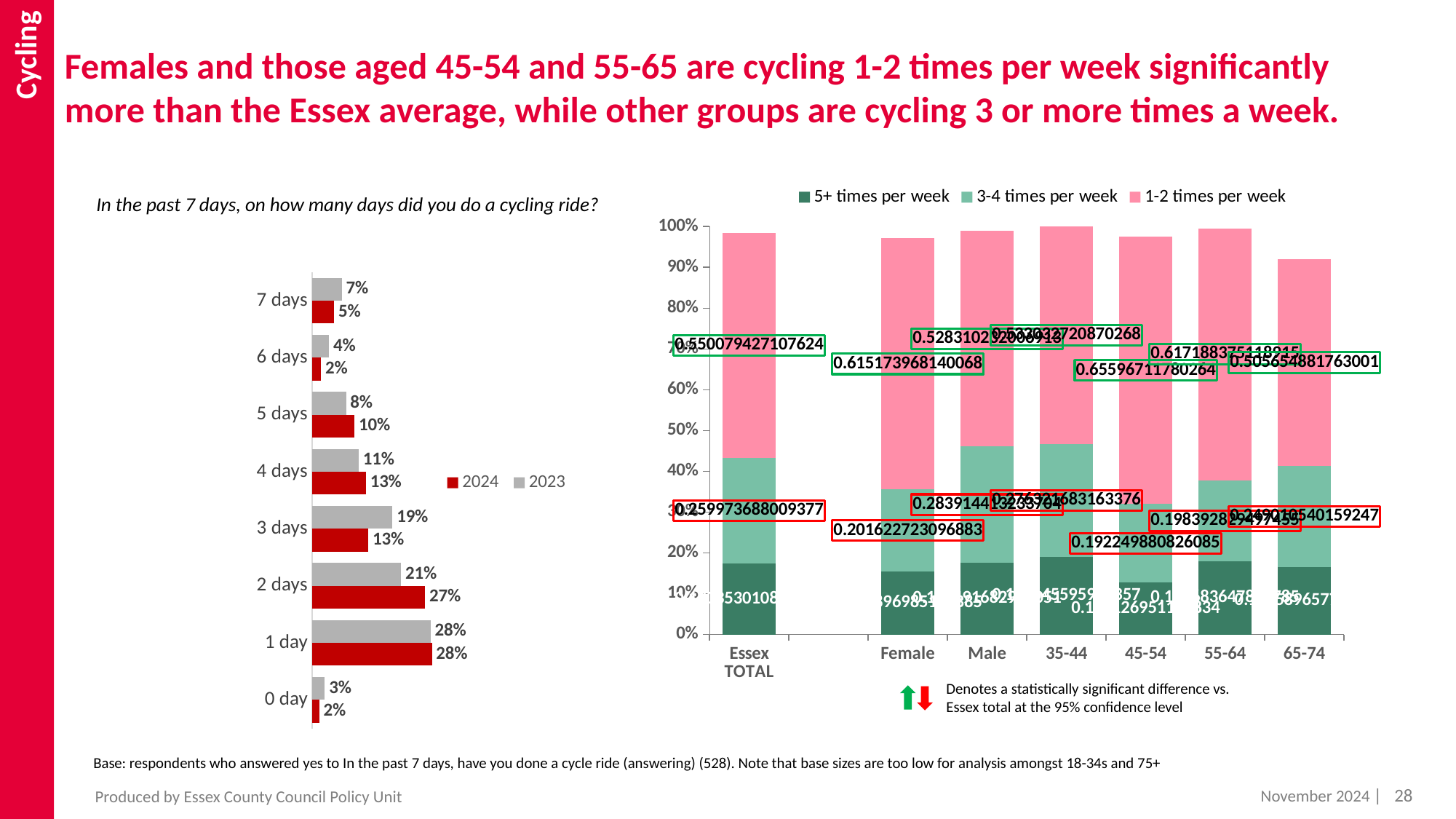
In the left chart, what is the difference between the 2024 and 2023 values for 2 days? 6 percentage points How many series does the legend of the left chart list? 2 How many series does the legend of the right stacked chart list? 3 In the left chart 'In the past 7 days, on how many days did you do a cycling ride?', what is the 2024 value for 2 days? 27% In the right stacked chart, is the '5+ times per week' segment for 35-44 greater or less than 10%? greater How many categories are shown along the x axis of the right stacked chart? 7 What kind of chart is the left chart? Bar chart In the left chart, which category has the highest 2024 value? 1 day In the left chart, what is the 2023 value for 3 days? 19% How many categories (day counts) are shown in the left chart? 8 In the left chart, for 3 days, which series has the larger value, 2024 or 2023? 2023 In the left chart, which category has the lowest 2023 value? 0 day